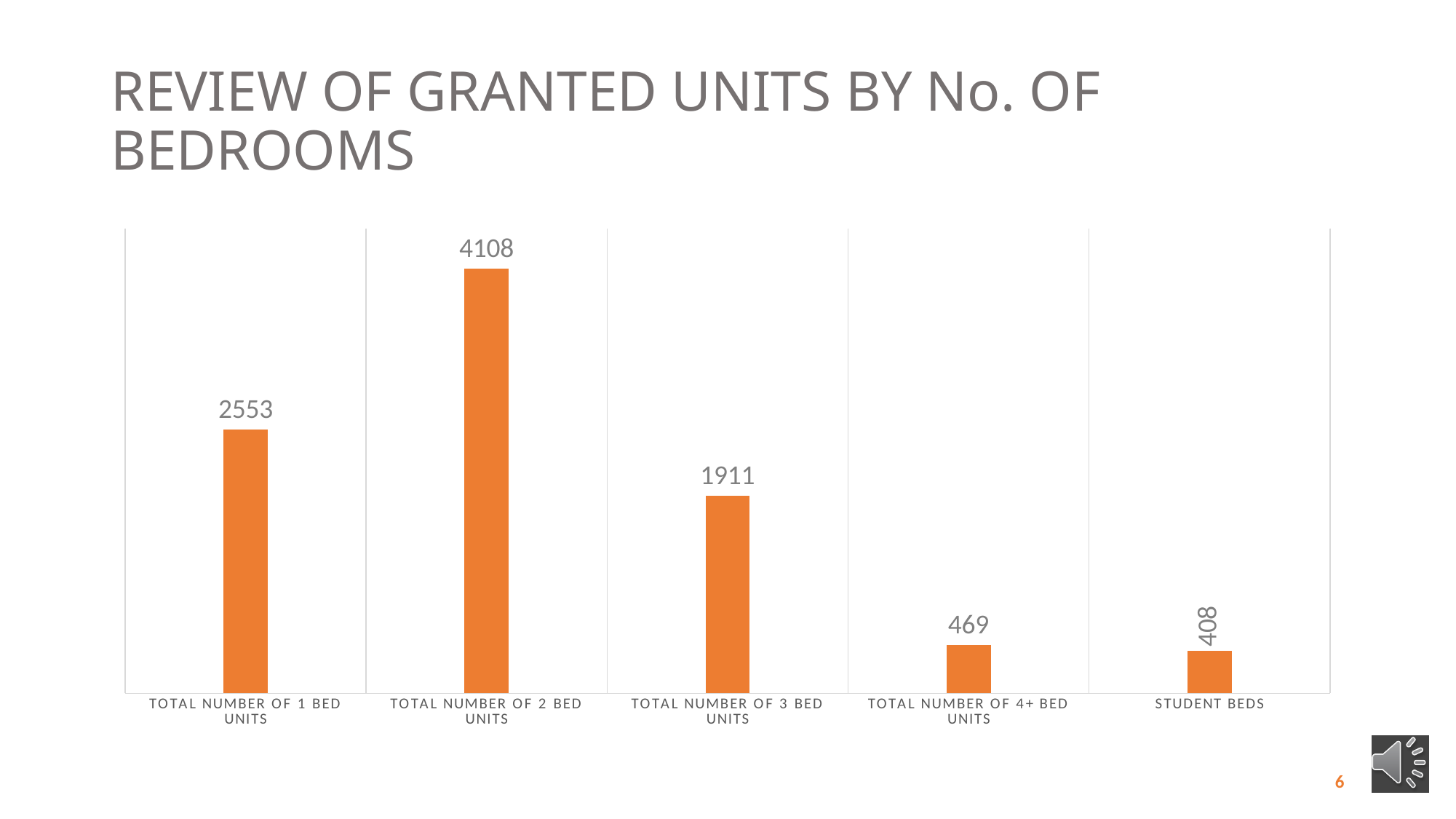
What is the difference between the values for Total Number of 2 Bed Units and Total Number of 1 Bed Units? 1555 What is the value for Student Beds? 408 Which is larger, the value for Total Number of 1 Bed Units or Total Number of 3 Bed Units? Total Number of 1 Bed Units What is the value for Total Number of 4+ Bed Units? 469 What kind of chart is shown on the slide? Bar chart What is the value for Total Number of 3 Bed Units? 1911 Which category has the highest value? Total Number of 2 Bed Units How many categories are shown on the chart? 5 What is the difference between the values for Total Number of 4+ Bed Units and Student Beds? 61 What is the value for Total Number of 2 Bed Units? 4108 What is the title of the slide containing the chart? Review of Granted Units by No. of Bedrooms Which category has the lowest value? Student Beds